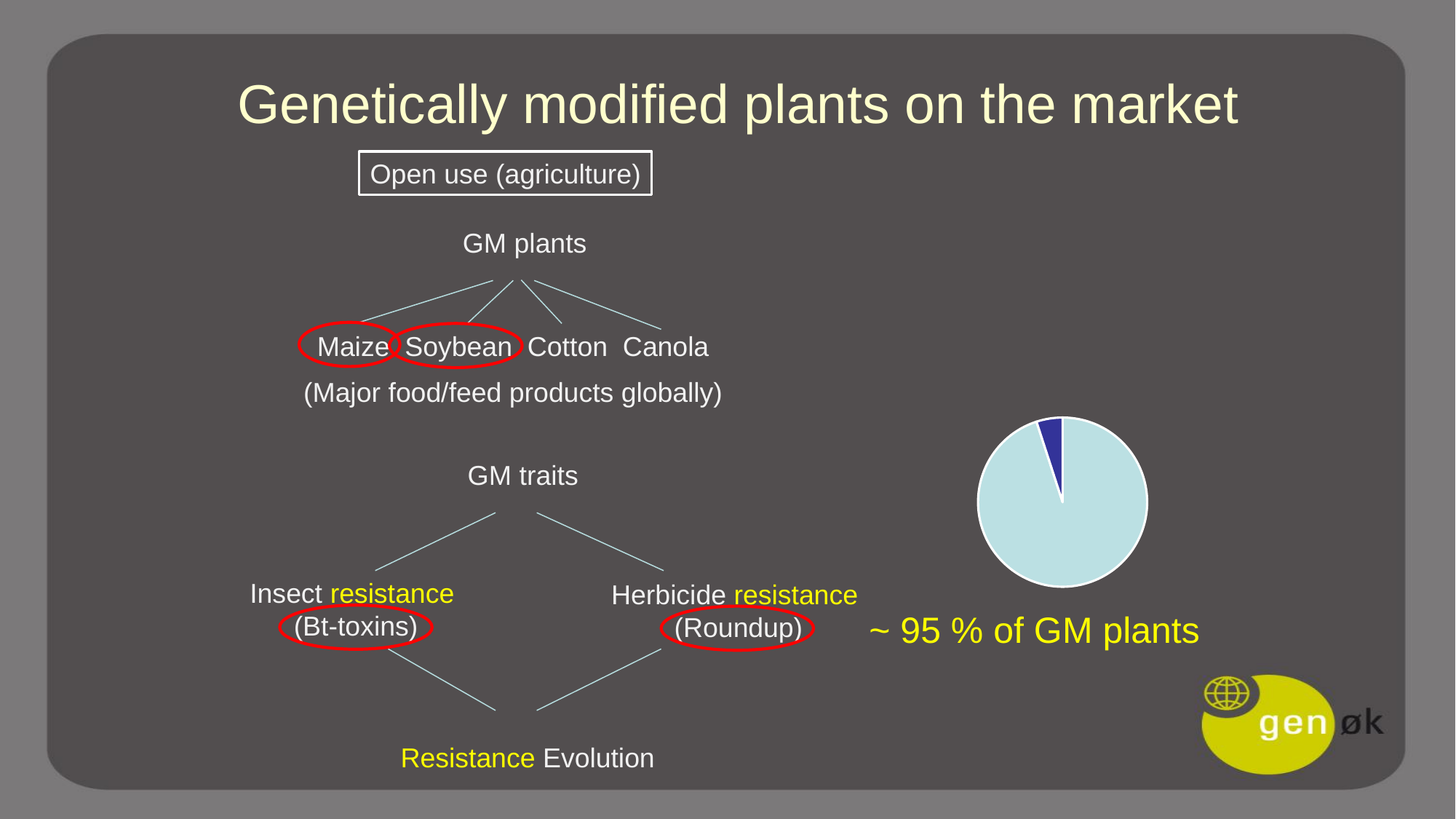
What colour is the small slice of the pie chart? dark blue How many slices does the pie chart on the slide have? 2 Does the pie chart on the slide have a legend? No What kind of chart is shown on the right side of the slide? pie chart Which slice of the pie chart is the smallest? the dark blue slice Which slice of the pie chart is the largest? the light blue slice In the pie chart, which slice is larger, the light blue one or the dark blue one? the light blue one